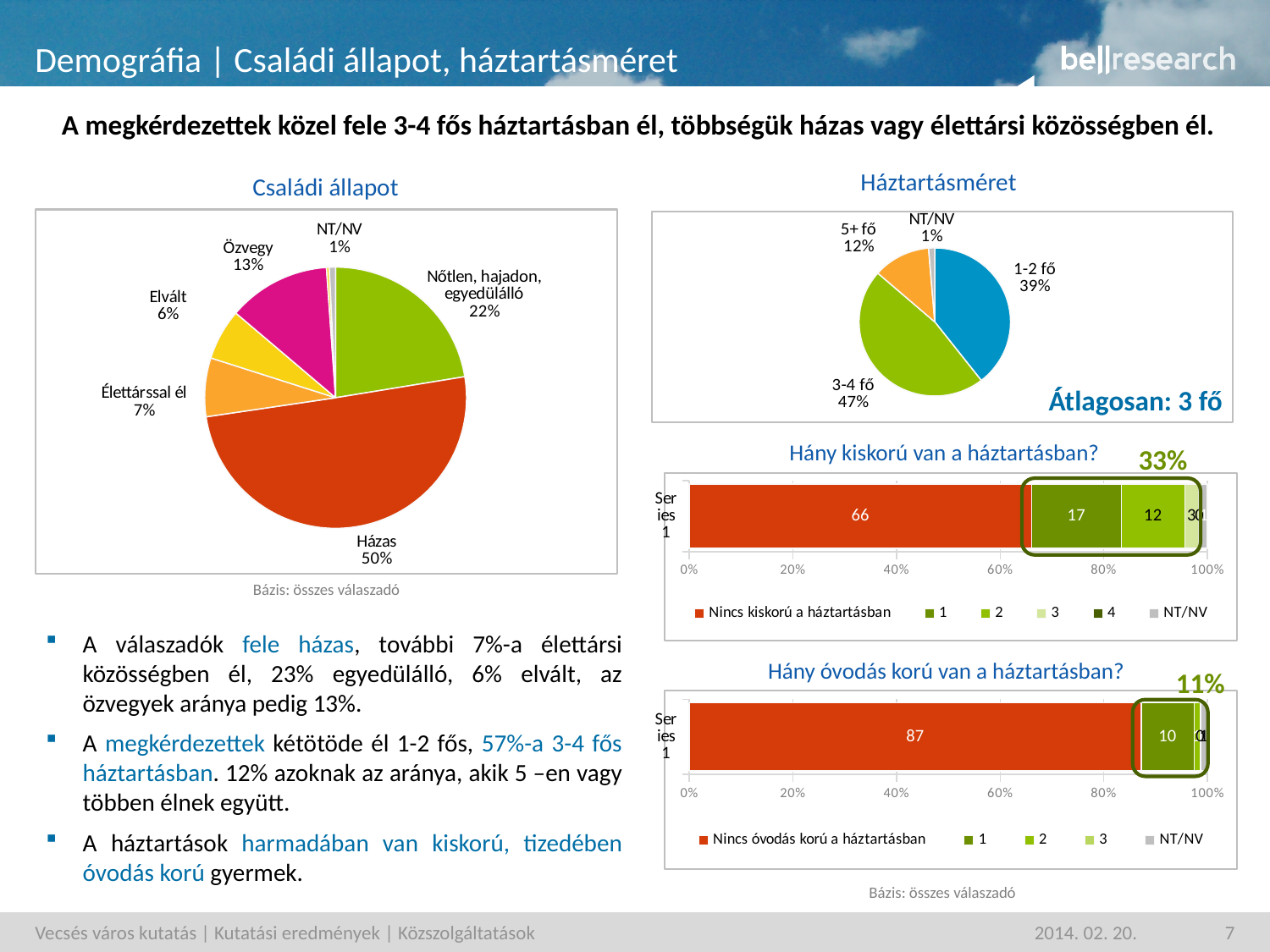
In the 'Családi állapot' pie chart, what percentage is shown for 'Özvegy'? 13% In the 'Háztartásméret' pie chart, which is larger: '1-2 fő' or '5+ fő'? 1-2 fő In the 'Hány kiskorú van a háztartásban?' chart, what value is shown for 'Nincs kiskorú a háztartásban'? 66 How many series does the legend of the 'Hány kiskorú van a háztartásban?' chart list? 6 In the 'Hány óvodás korú van a háztartásban?' chart, what value is shown for the series '1'? 10 In the 'Háztartásméret' pie chart, which category has the smallest slice? NT/NV In the 'Családi állapot' pie chart, which category has the largest slice? Házas In the 'Családi állapot' pie chart, what share is shown for 'Házas'? 50% What type of chart is the 'Háztartásméret' chart? Pie chart In the 'Családi állapot' pie chart, what is the difference in percentage points between 'Nőtlen, hajadon, egyedülálló' and 'Özvegy'? 9 percentage points In the 'Háztartásméret' pie chart, what share is shown for '3-4 fő'? 47%